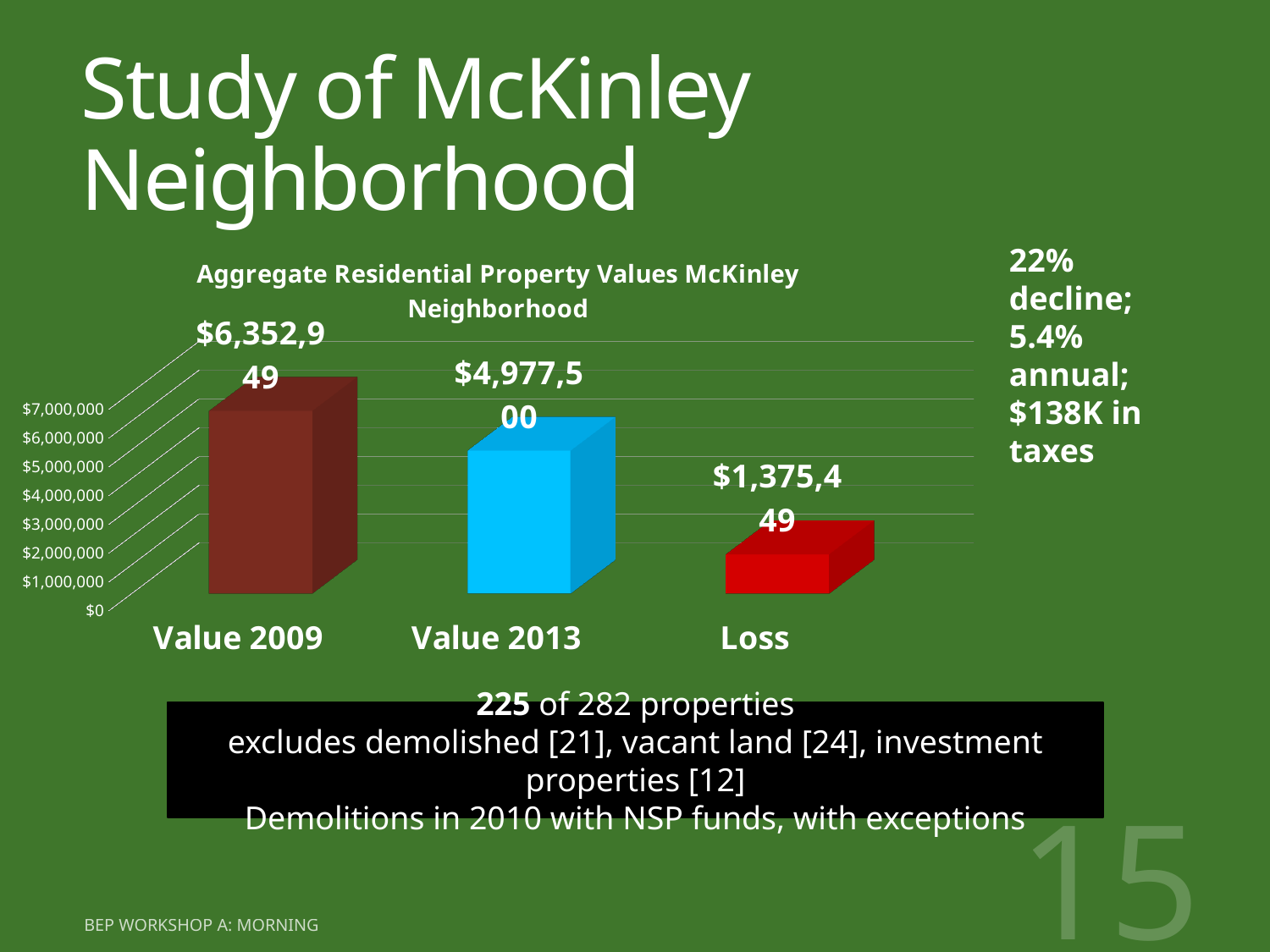
Is the value for Value 2013 greater or less than $4,000,000? greater Which is larger, Value 2013 or Loss? Value 2013 What is the value for Value 2013 in the chart? $4,977,500 What is the title of the chart? Aggregate Residential Property Values McKinley Neighborhood What is the value shown for Loss in the chart? $1,375,449 Which category has the highest value in the chart? Value 2009 What is the value for Value 2009 in the Aggregate Residential Property Values McKinley Neighborhood chart? $6,352,949 What is the difference between Value 2009 and Value 2013? $1,375,449 What kind of chart is shown on the slide? bar chart Is the value for Loss greater or less than $2,000,000? less Which category has the lowest value in the chart? Loss How many categories are shown in the chart? 3